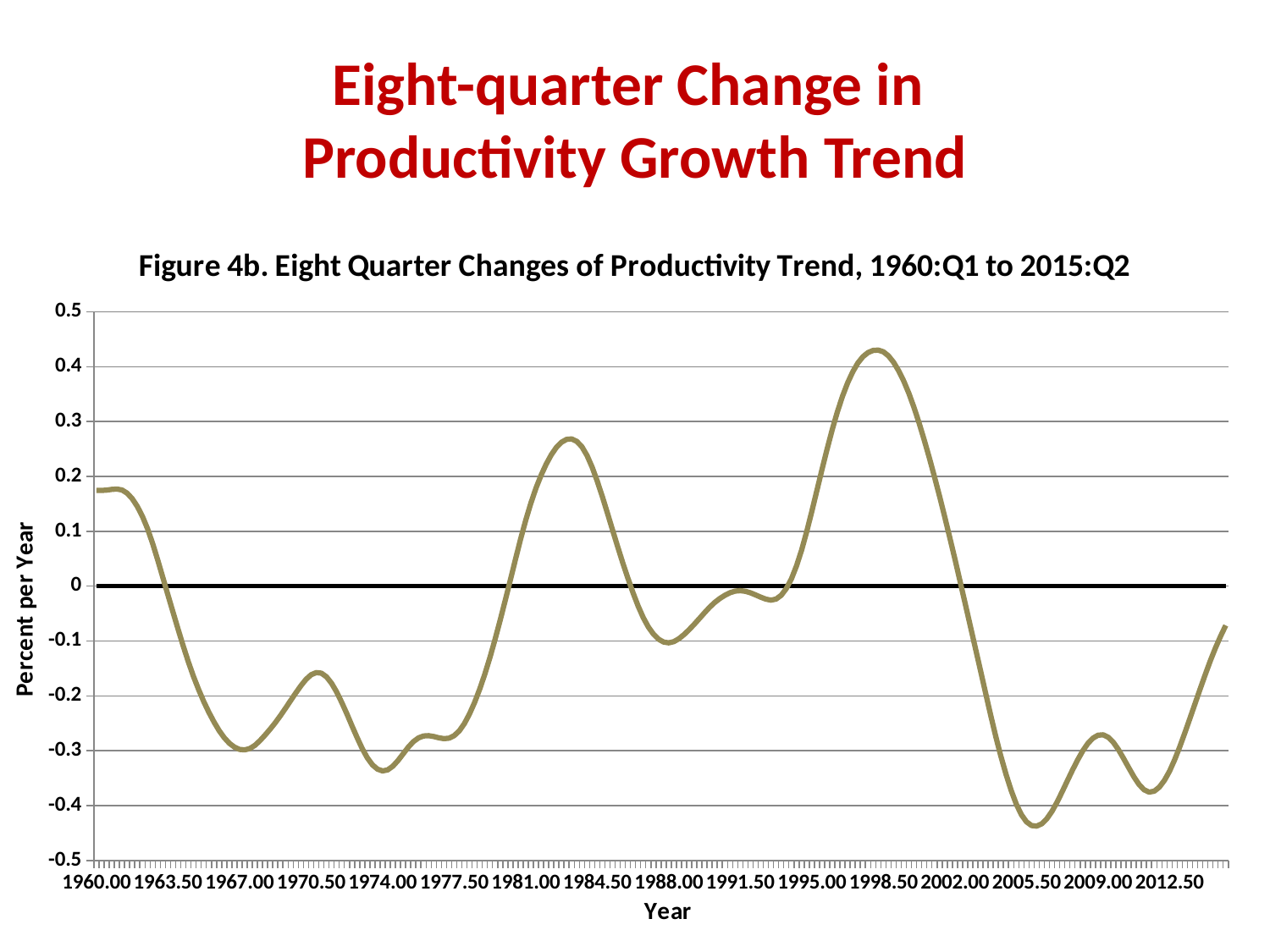
Is the value at 1960.00 greater or less than 0.1? greater Is the value at 1998.50 greater or less than 0.3? greater Is the value at 2005.50 greater or less than -0.4? less What is the title of the chart? Figure 4b. Eight Quarter Changes of Productivity Trend, 1960:Q1 to 2015:Q2 What kind of chart is shown on the slide? line chart Does the line rise or fall between 2002.00 and 2005.50? fall What is the label of the vertical axis? Percent per Year Near which x-axis tick label does the line reach its lowest value? 2005.50 Near which x-axis tick label does the line reach its highest value? 1998.50